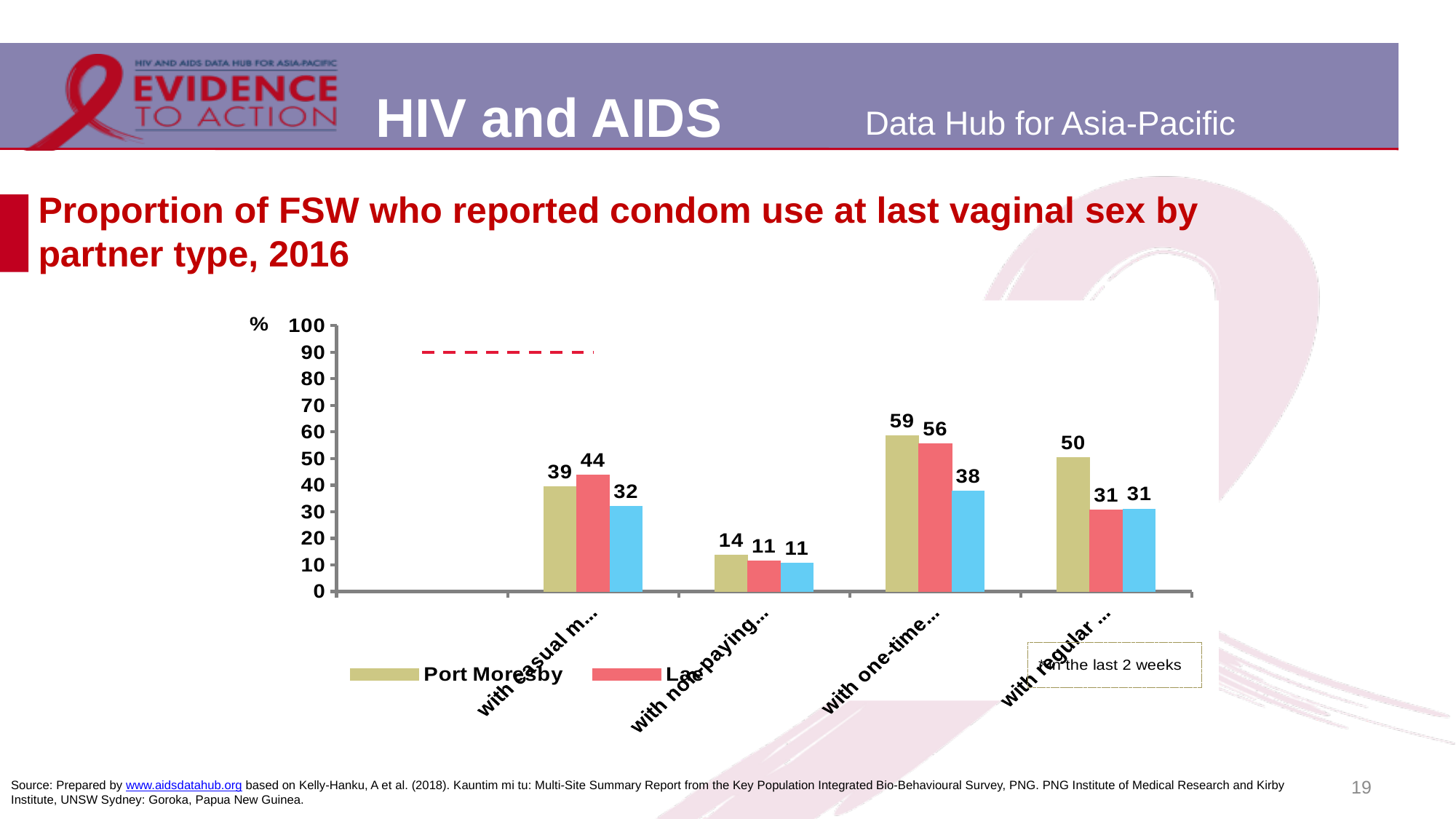
What is the Port Moresby value for the 'with one-time...' partner type? 59 How many partner-type categories are shown on the x axis? 4 For which partner type is the Lae value lowest? with non-paying... What kind of chart is shown on the slide? Bar chart At what value on the y axis is the red dashed reference line drawn? 90 What is the Port Moresby value for the 'with regular ...' partner type? 50 What is the difference between the Port Moresby and Lae values for the 'with one-time...' partner type? 3 What is the Lae value for the 'with non-paying...' partner type? 11 For the first partner type ('with casual m...'), which is larger: the Port Moresby value or the Lae value? Lae What is the difference between the Port Moresby and Lae values for the 'with regular ...' partner type? 19 What is the Lae value for the first partner type ('with casual m...')? 44 For which partner type is the Port Moresby value highest? with one-time...